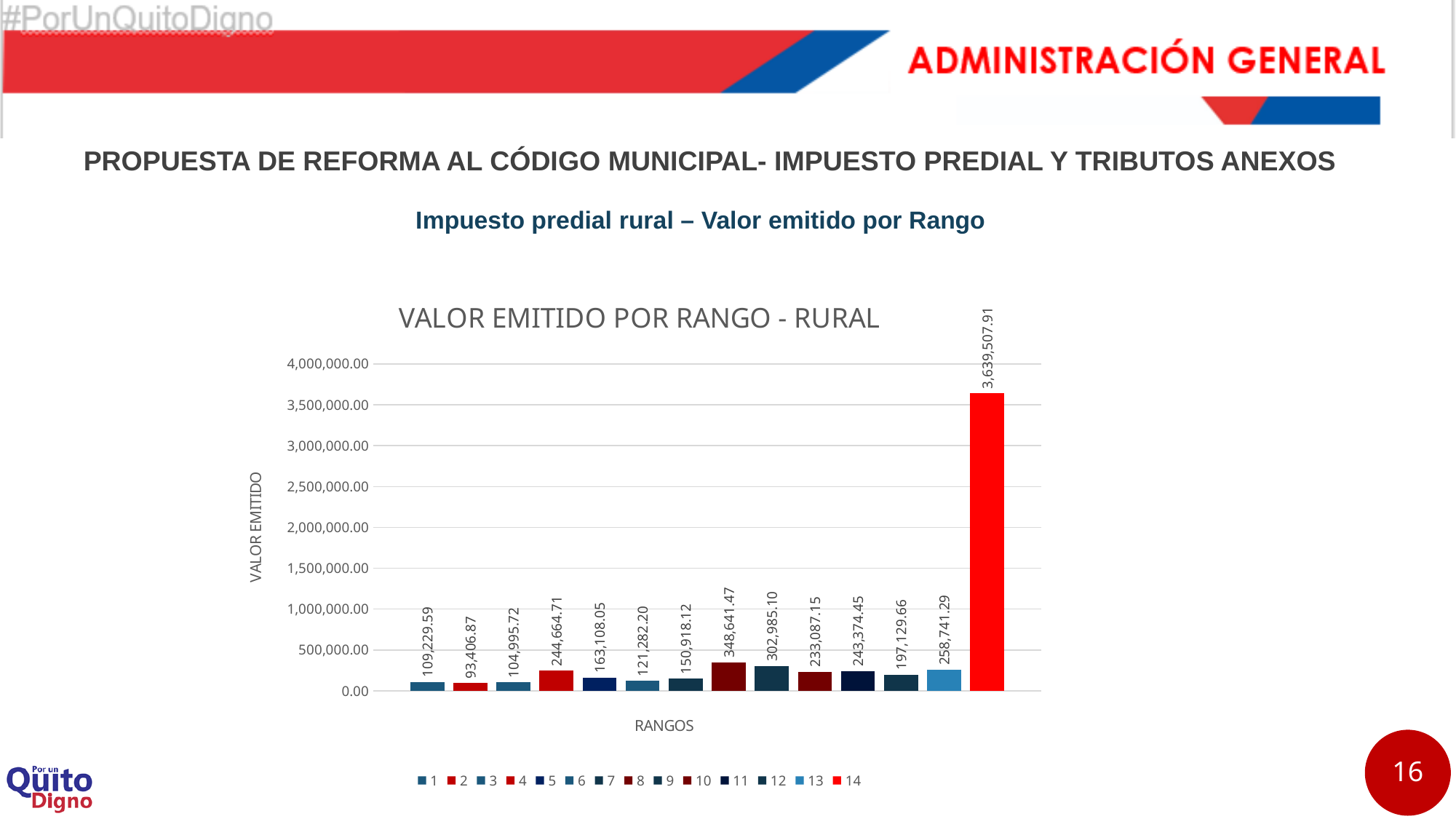
Which range has the highest value emitted? 14 What is the value emitted for range 5? 163,108.05 What is the title of the chart? VALOR EMITIDO POR RANGO - RURAL What is the value emitted for range 8? 348,641.47 Which range has the lowest value emitted? 2 What type of chart is shown on the slide? Bar chart Which has a larger value emitted, range 4 or range 13? 13 Is the value for range 14 greater or less than 3,500,000.00? greater What is the value emitted for range 14? 3,639,507.91 How many ranges (categories) are plotted in the chart? 14 What is the difference between the values for range 8 and range 9? 45,656.37 How many entries does the chart legend list? 14